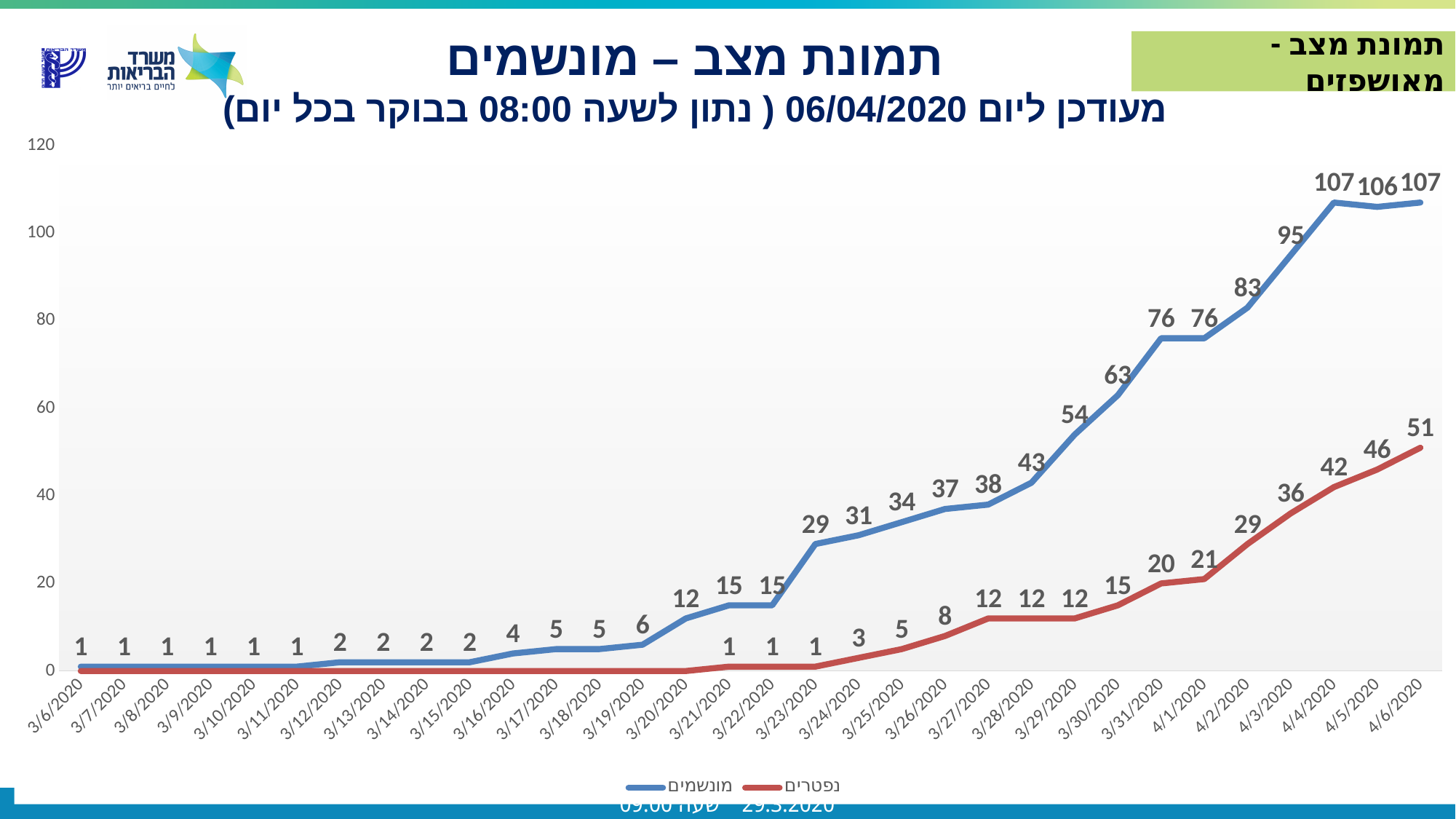
What is the value of the מונשמים series on 4/6/2020? 107 What colour is the line for the נפטרים series? red What is the value of the נפטרים series on 3/31/2020? 20 What kind of chart is shown on the slide? line chart What is the highest value reached by the מונשמים series? 107 Does the מונשמים series generally rise or fall from 3/6/2020 to 4/6/2020? rise How many dates are shown on the x axis? 32 How many series does the legend list? 2 On 4/3/2020, which series has the larger value, מונשמים or נפטרים? מונשמים What is the value of the מונשמים series on 3/23/2020? 29 What is the difference between the מונשמים value and the נפטרים value on 4/6/2020? 56 What is the value of the נפטרים series on 4/6/2020? 51